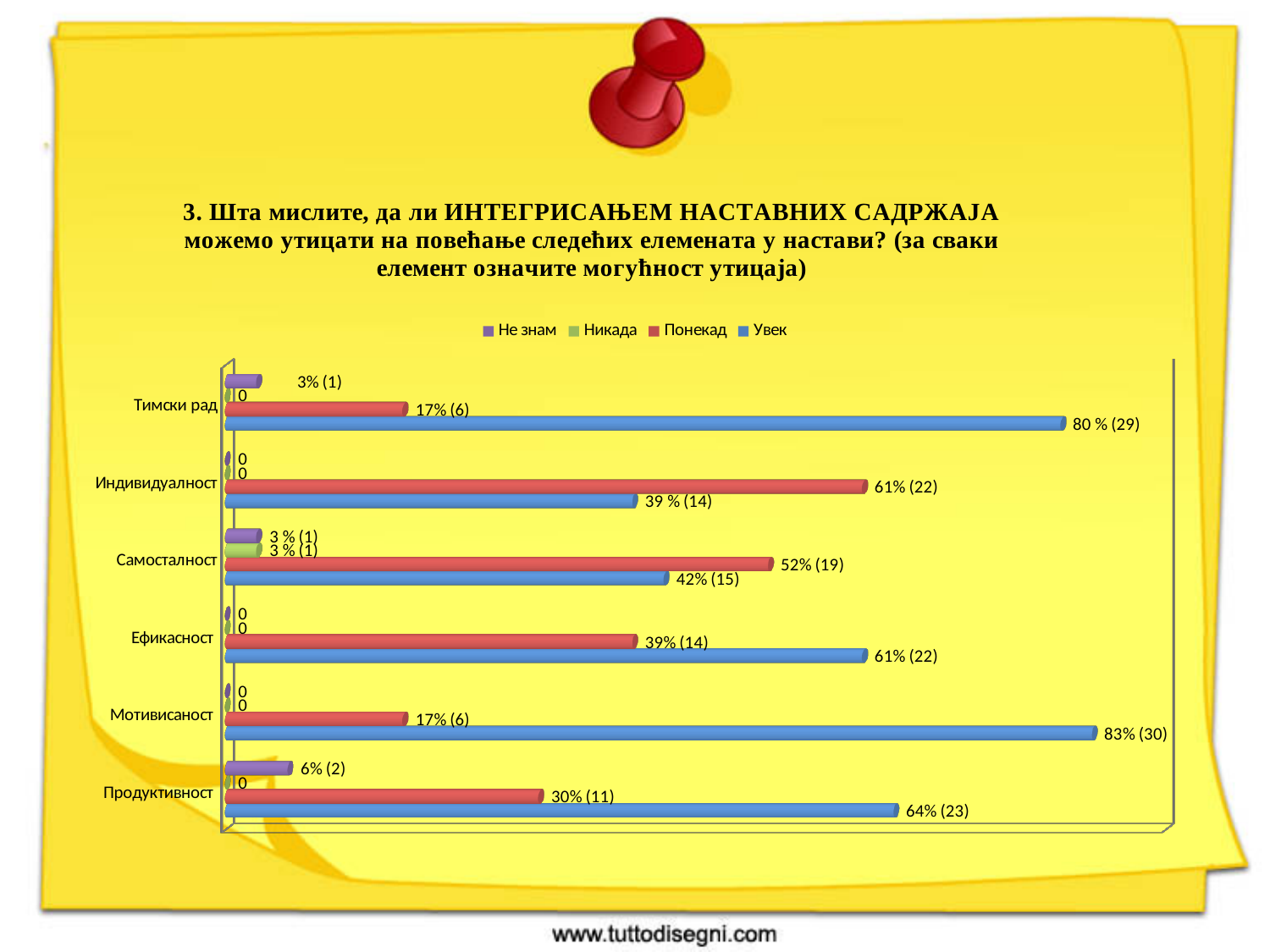
How many categories are plotted on the chart? 6 What kind of chart is shown on the slide? bar chart How many series does the legend list? 4 Which category has the lowest value in the Увек series? Индивидуалност What is the value of the Увек series for Тимски рад? 80 % (29) For Ефикасност, which is larger: the Понекад value or the Увек value? Увек Which category has the highest value in the Увек series? Мотивисаност What is the difference in percentage points between the Увек values for Мотивисаност and Продуктивност? 19 What is the value of the Не знам series for Продуктивност? 6% (2) What is the value of the Увек series for Мотивисаност? 83% (30) Which legend entry is shown in blue? Увек What is the value of the Понекад series for Индивидуалност? 61% (22)